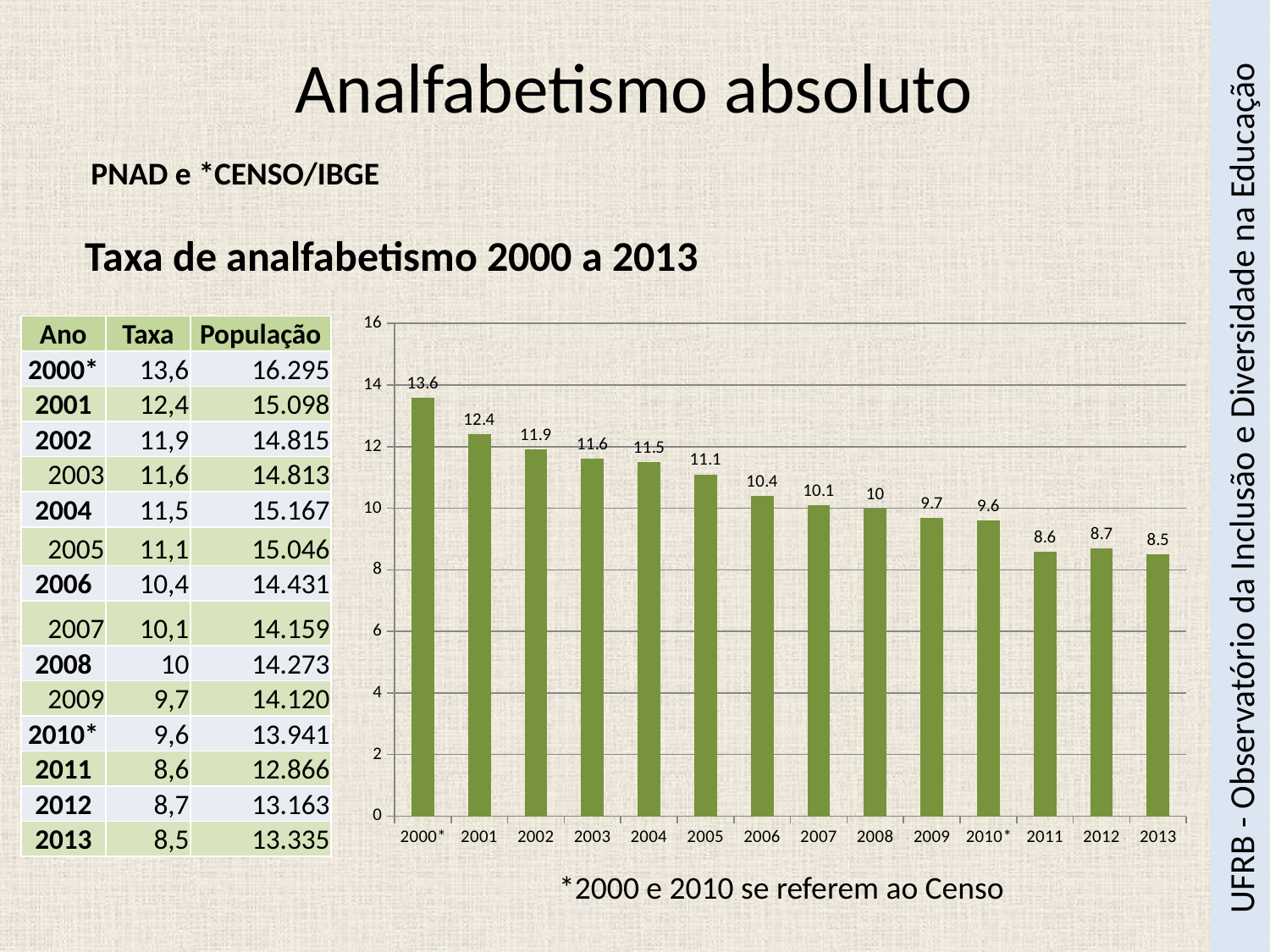
What kind of chart is shown on the slide? bar chart What is the value shown for 2008 in the chart? 10 Which year has the lowest value in the chart? 2013 What is the value shown for 2005 in the chart? 11.1 What is the title of the chart section on the slide? Taxa de analfabetismo 2000 a 2013 How many years are plotted in the chart? 14 Which year has the highest value in the chart? 2000* Which is larger, the value for 2011 or the value for 2012? 2012 Do the values generally rise or fall from 2000* to 2013? fall What is the difference between the values for 2000* and 2013? 5.1 Is the value for 2006 greater or less than 12? less What is the value shown for 2010* in the chart? 9.6